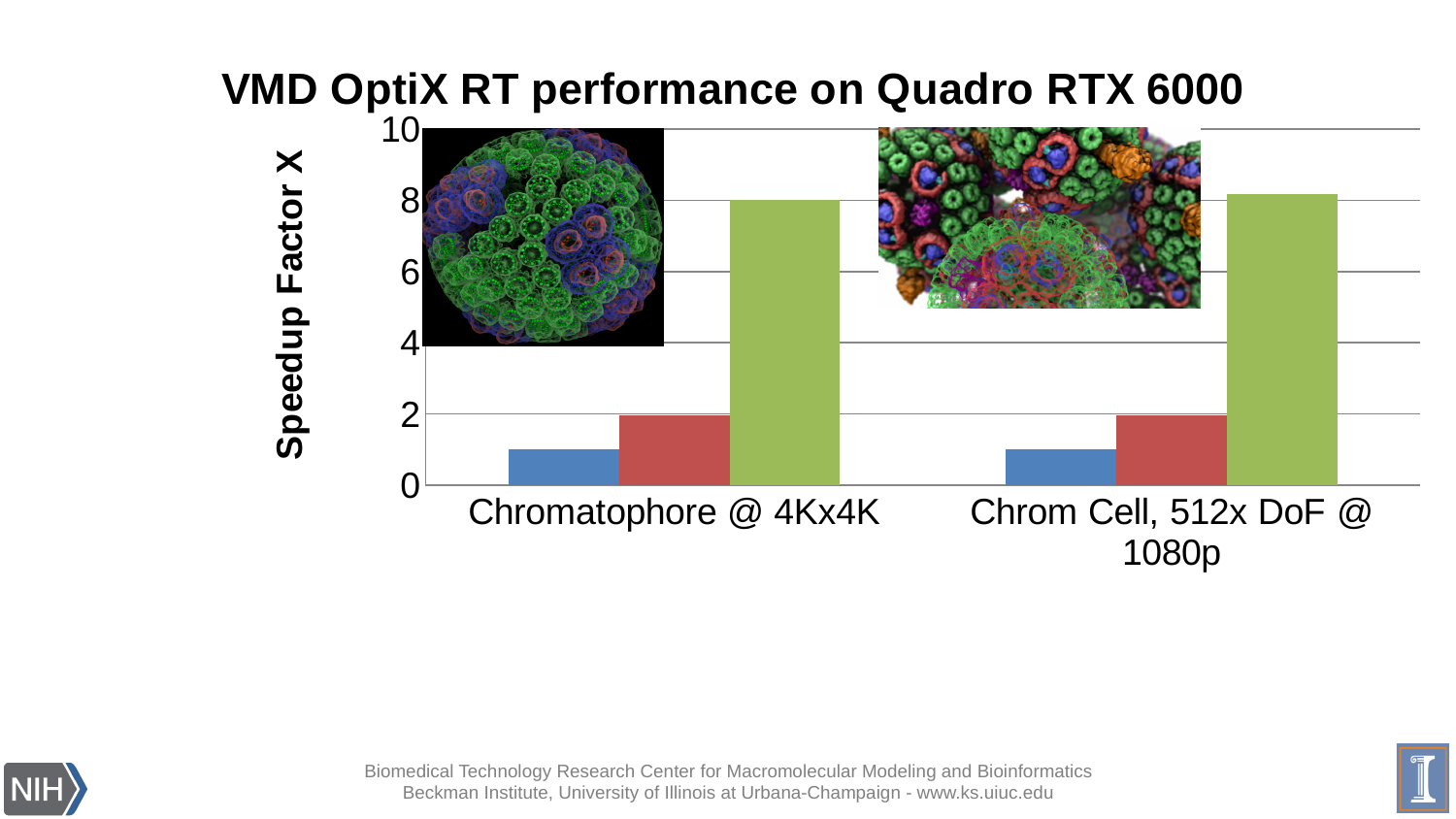
For 'Chrom Cell, 512x DoF @ 1080p', which is larger, the red bar or the green bar? the green bar Is the green bar for 'Chrom Cell, 512x DoF @ 1080p' greater or less than 6? greater How many bars are plotted for the category 'Chromatophore @ 4Kx4K'? 3 Which coloured bar is the tallest for 'Chromatophore @ 4Kx4K'? the green bar What kind of chart is shown on the slide? bar chart How many categories are shown on the x axis? 2 Which coloured bar is the shortest for 'Chrom Cell, 512x DoF @ 1080p'? the blue bar What is the label of the vertical axis? Speedup Factor X What is the highest value shown on the vertical axis? 10 What is the title of the chart? VMD OptiX RT performance on Quadro RTX 6000 Is the blue bar for 'Chromatophore @ 4Kx4K' greater or less than 2? less Is the green bar for 'Chromatophore @ 4Kx4K' greater or less than 10? less